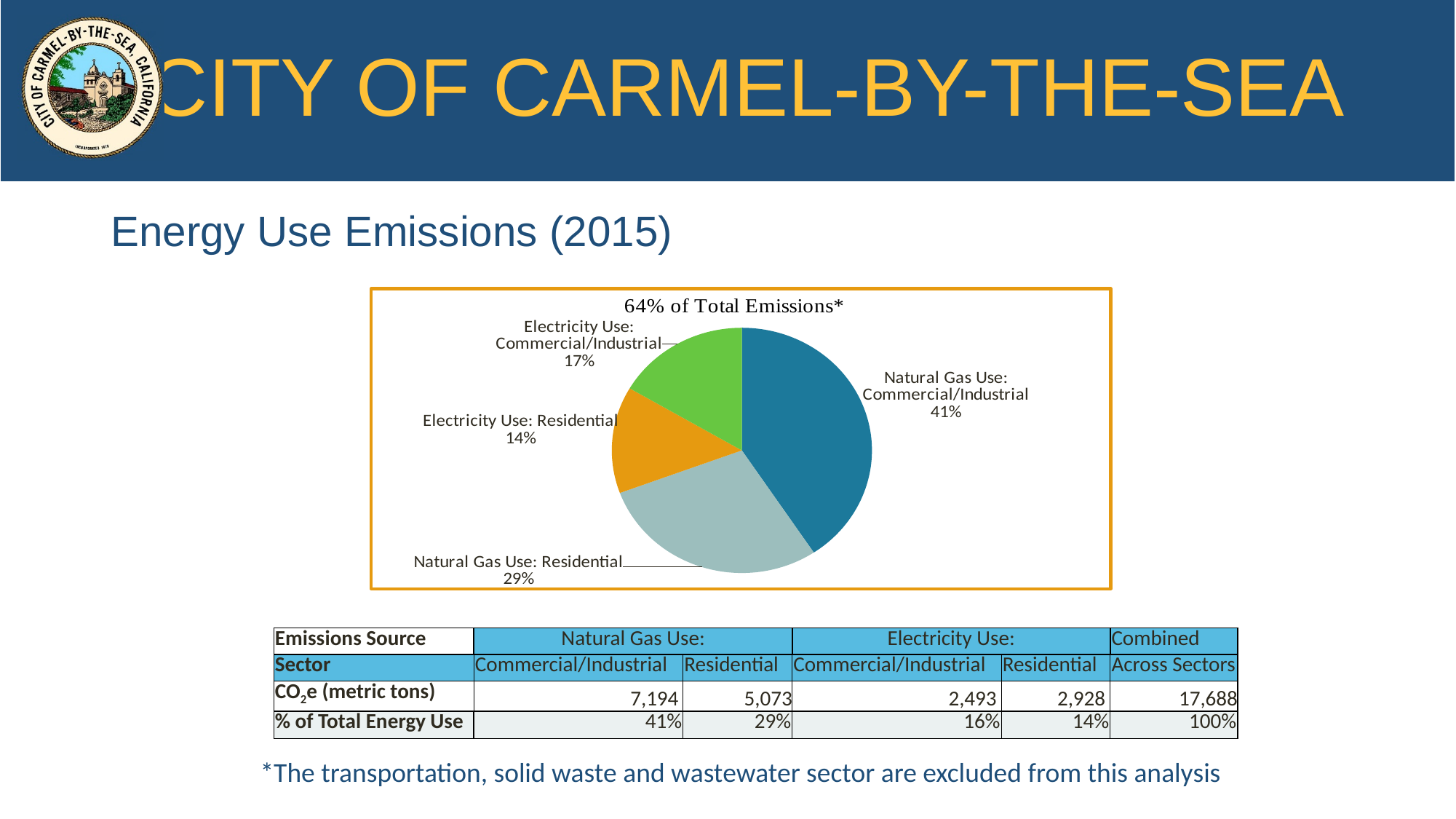
What share of the pie does Natural Gas Use: Residential represent? 29% What colour is the Natural Gas Use: Residential slice in the pie chart? light grey-blue Which slice of the pie chart is the smallest? Electricity Use: Residential What share of the pie does Natural Gas Use: Commercial/Industrial represent? 41% What is the title of the pie chart? 64% of Total Emissions* How many slices does the pie chart have? 4 What share of the pie does Electricity Use: Commercial/Industrial represent? 17% What is the difference in percentage points between the Natural Gas Use: Commercial/Industrial slice and the Natural Gas Use: Residential slice? 12 percentage points Which slice of the pie chart is the largest? Natural Gas Use: Commercial/Industrial Which is larger in the pie chart: Natural Gas Use: Residential or Electricity Use: Commercial/Industrial? Natural Gas Use: Residential What type of chart is shown on the slide? pie chart